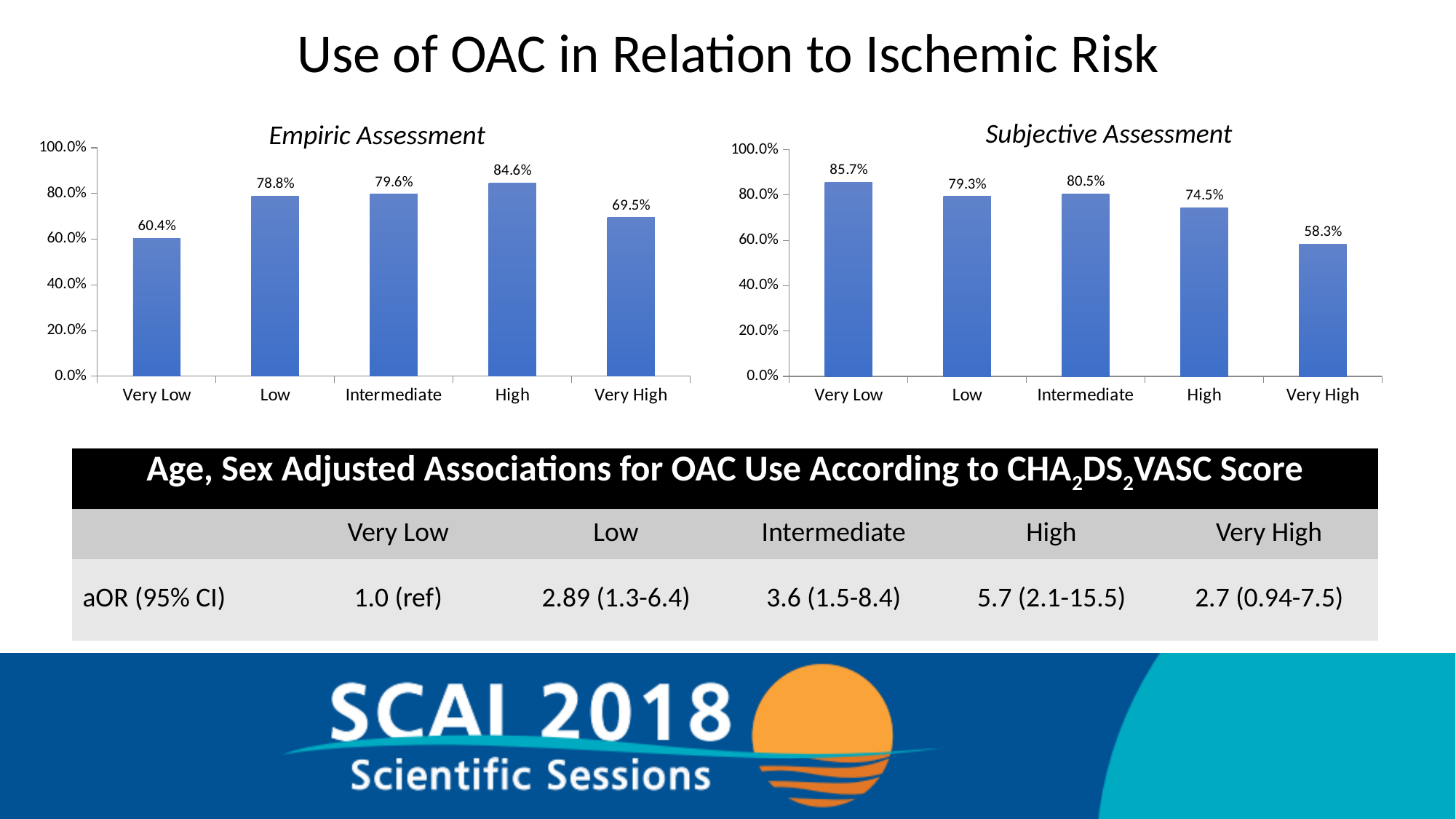
In the Subjective Assessment chart, which is larger, the value for Intermediate or the value for High? Intermediate In the Subjective Assessment chart, what is the difference between the Very Low and Very High values? 27.4% In the Empiric Assessment chart, what is the difference between the High and Very Low values? 24.2% In the Empiric Assessment chart, which category has the lowest value? Very Low In the Empiric Assessment chart, what is the value for the High category? 84.6% In the Empiric Assessment chart, is the value for Very High greater or less than 80.0%? less In the Subjective Assessment chart, which category has the highest value? Very Low What kind of chart is the Empiric Assessment chart? bar chart How many categories are shown in the Subjective Assessment chart? 5 In the Subjective Assessment chart, what is the value for the Very High category? 58.3% What is the title of the chart on the right side of the slide? Subjective Assessment In the Subjective Assessment chart, what is the value for Low? 79.3%